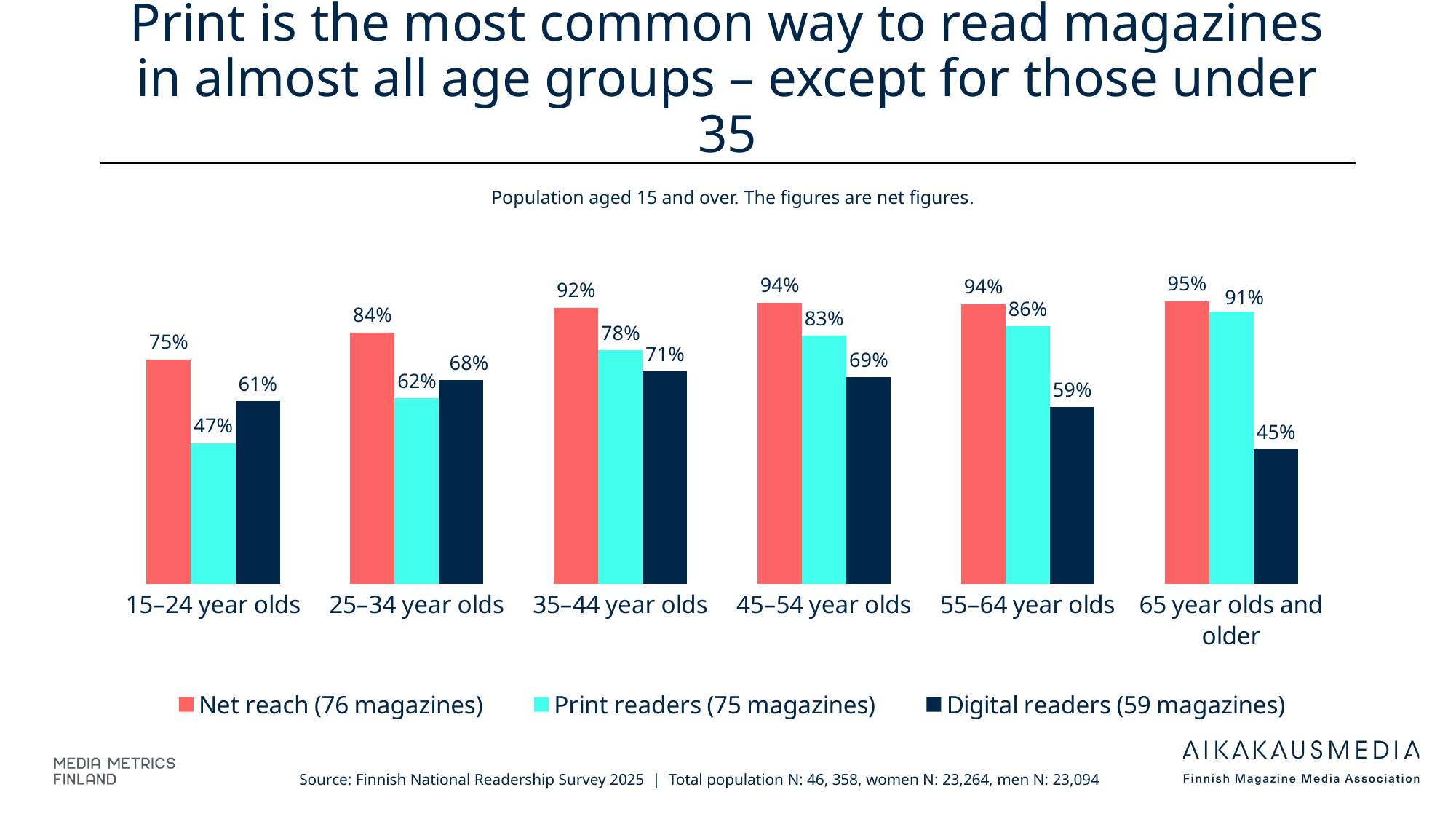
What is the difference between the Print readers and Digital readers values for 55–64 year olds? 27% How many age groups are shown on the x axis? 6 Do the Digital readers values rise or fall from 45–54 year olds to 65 year olds and older? Fall How many series does the legend list? 3 How many magazines does the legend say the Digital readers series covers? 59 magazines Which age group has the highest Print readers value? 65 year olds and older Which age group has the lowest Digital readers value? 65 year olds and older What is the Net reach value for 35–44 year olds? 92% What kind of chart is shown on the slide? Bar chart For 25–34 year olds, which is larger: Print readers or Digital readers? Digital readers What is the Print readers value for 15–24 year olds? 47% What is the Digital readers value for 65 year olds and older? 45%